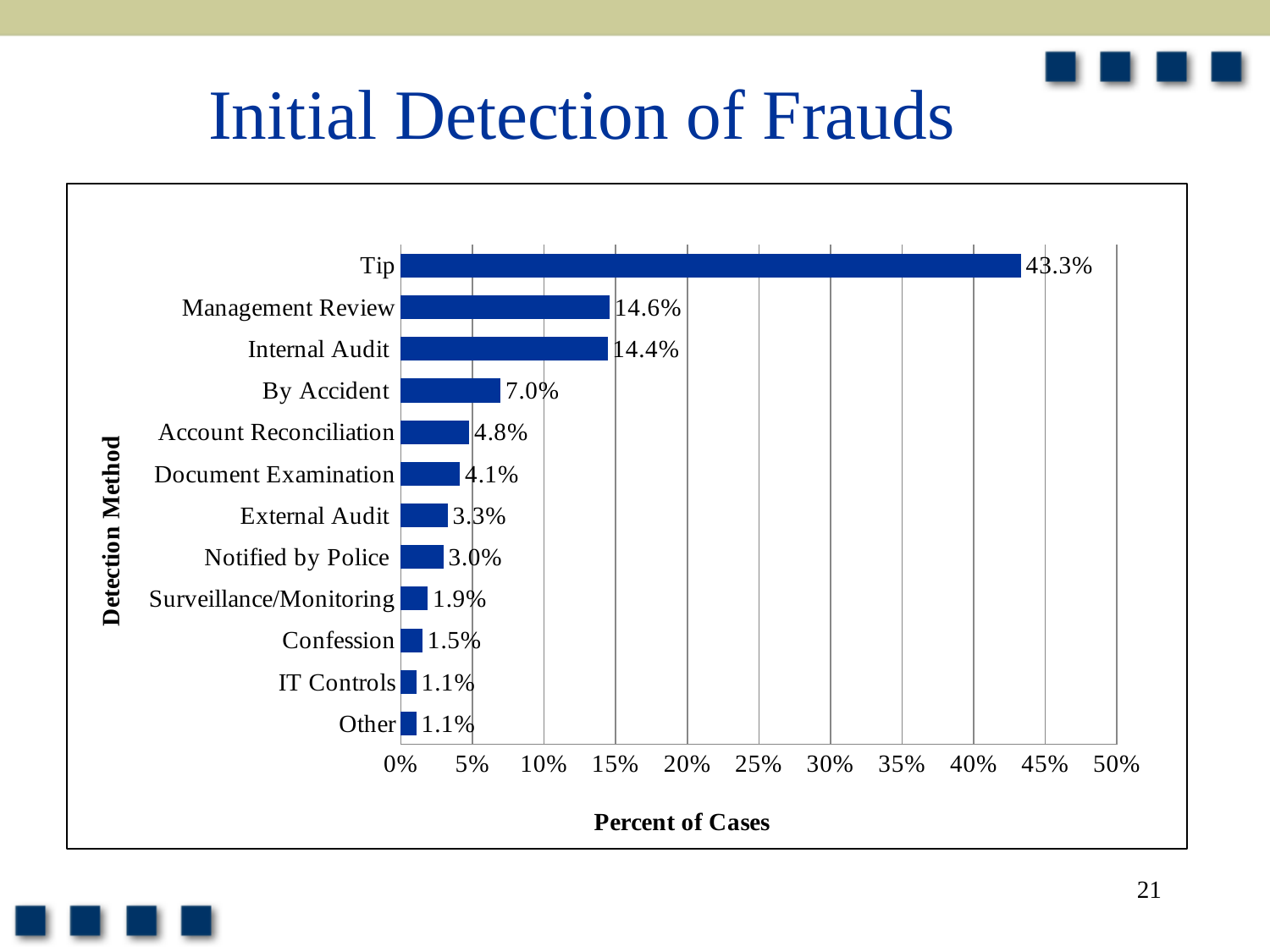
How many detection methods are shown on the chart? 12 What is the difference between Tip and Management Review? 28.7% What is the difference between Management Review and Internal Audit? 0.2% What is the value for Surveillance/Monitoring? 1.9% What is the label of the horizontal axis? Percent of Cases What percent of cases were initially detected by Tip? 43.3% Which detection method has the highest percent of cases? Tip What is the value for Internal Audit? 14.4% Which is larger, Account Reconciliation or Document Examination? Account Reconciliation Which is larger, External Audit or By Accident? By Accident What percent of cases were detected By Accident? 7.0% What kind of chart is shown on the slide? Bar chart